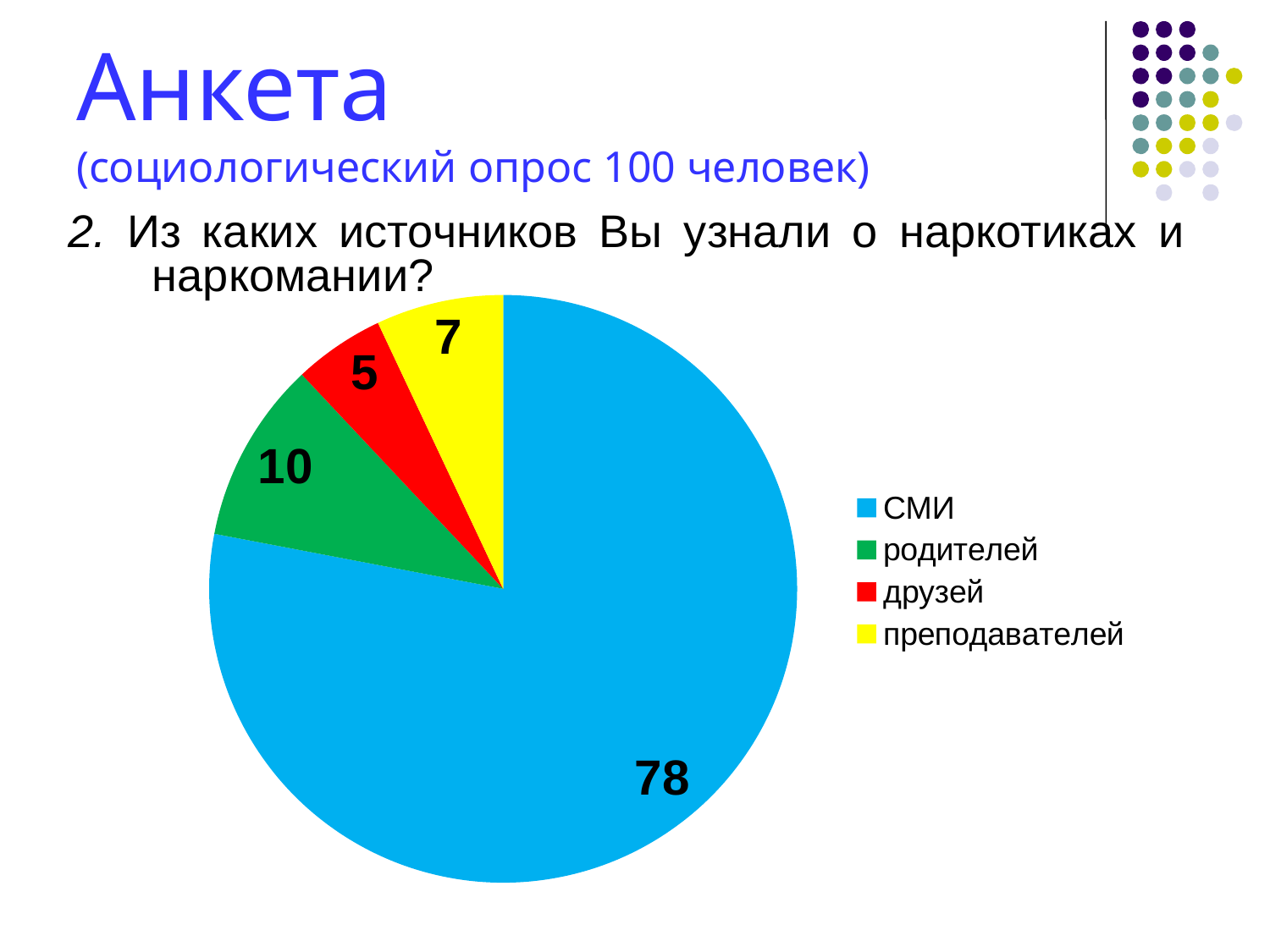
What is the value for друзей in the pie chart? 5 How many slices does the pie chart have? 4 What is the difference between the values for СМИ and родителей? 68 What is the value for СМИ in the pie chart? 78 Which category has the largest slice in the pie chart? СМИ What share of the pie does the СМИ slice represent? 78% What is the value for преподавателей in the pie chart? 7 Which is larger, the value for преподавателей or the value for друзей? преподавателей Which category has the smallest slice in the pie chart? друзей What is the value for родителей in the pie chart? 10 What colour is the slice for родителей? green What type of chart is shown on the slide? pie chart